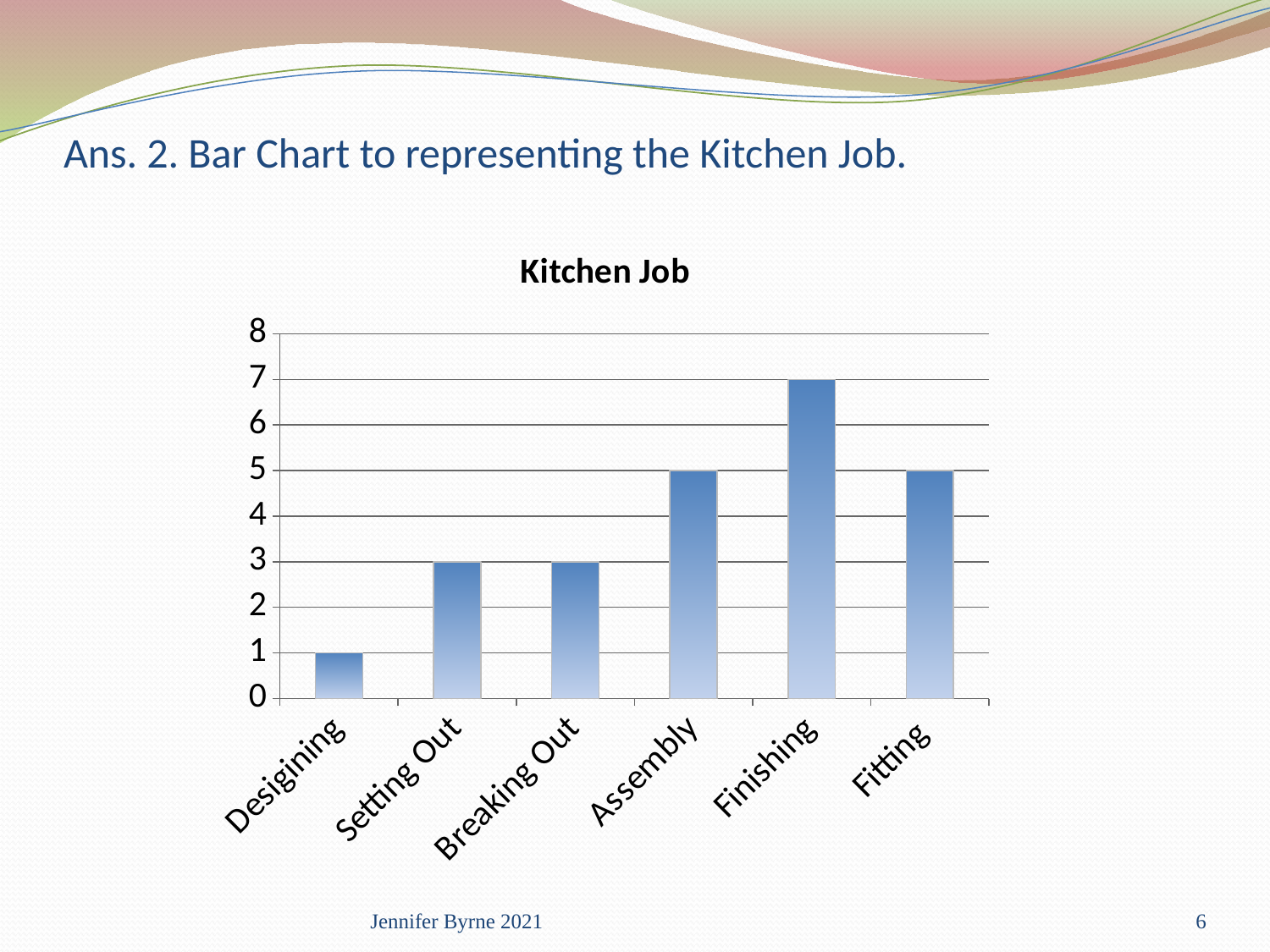
Which category has the lowest value? Desigining How many categories are shown on the x axis? 6 What is the difference between the values for Finishing and Desigining? 6 What kind of chart is shown on the slide? Bar chart What is the value for Setting Out? 3 What is the title of the chart? Kitchen Job Which is larger, the value for Assembly or the value for Breaking Out? Assembly What is the value for Finishing? 7 What is the value for Assembly? 5 What is the highest value shown on the vertical axis? 8 Is the value for Fitting greater or less than 4? greater Which category has the highest value? Finishing